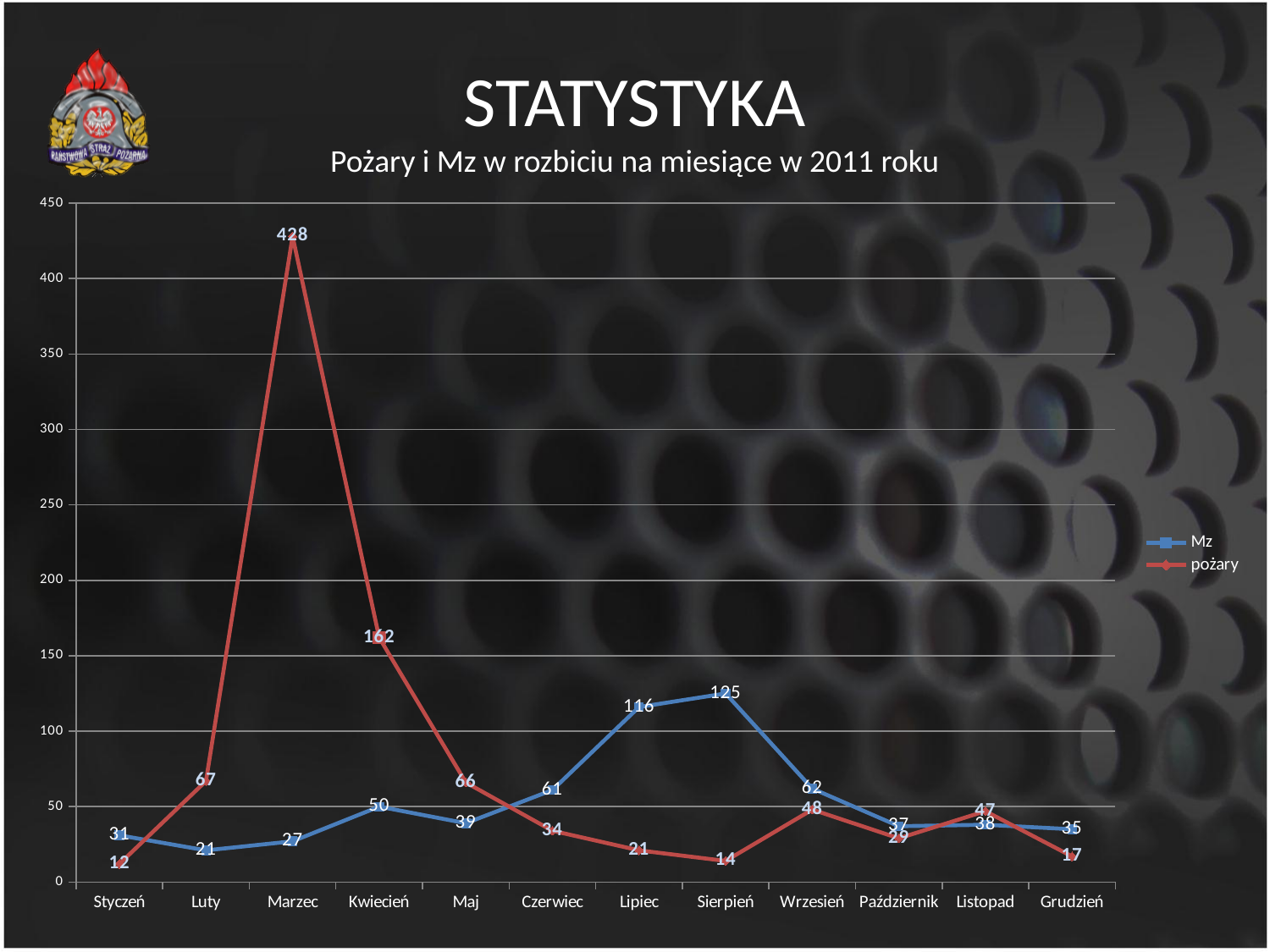
What is the value of Mz in Sierpień? 125 What is the value of Mz in Lipiec? 116 In which month is the Mz series lowest? Luty How many months are shown on the x axis? 12 What is the value of pożary in Marzec? 428 What is the value of pożary in Kwiecień? 162 In which month is the pożary series highest? Marzec How many series does the legend list? 2 Which is larger in Wrzesień: Mz or pożary? Mz What kind of chart is shown on the slide? Line chart What is the difference between pożary in Marzec and pożary in Kwiecień? 266 What is the subtitle of the chart below 'STATYSTYKA'? Pożary i Mz w rozbiciu na miesiące w 2011 roku